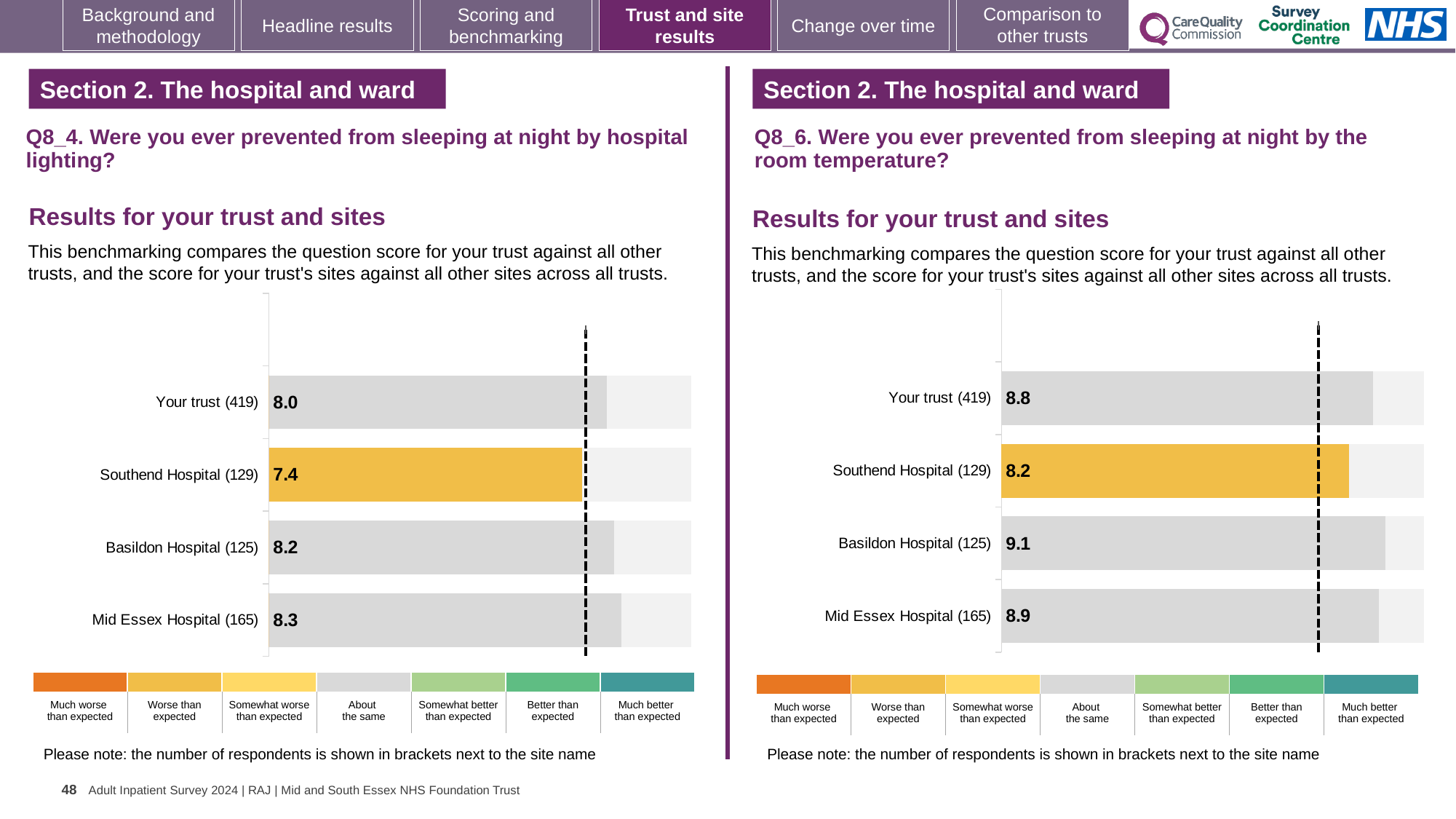
In the Q8_4 chart (hospital lighting), which site has the lowest score? Southend Hospital In the Q8_4 chart (hospital lighting), what is the difference between the scores for Mid Essex Hospital and Southend Hospital? 0.9 In the Q8_4 chart (hospital lighting), which site has the highest score? Mid Essex Hospital In the Q8_6 chart (room temperature), what is the score for Mid Essex Hospital? 8.9 In the Q8_4 chart (hospital lighting), what is the score for Southend Hospital? 7.4 What type of chart is used for the Q8_6 results (room temperature)? Bar chart In the Q8_6 chart (room temperature), which site has the lowest score? Southend Hospital In the Q8_6 chart (room temperature), what is the difference between the scores for Your trust and Southend Hospital? 0.6 In the Q8_4 chart (hospital lighting), what is the score for Your trust? 8.0 In the Q8_6 chart (room temperature), what is the score for Basildon Hospital? 9.1 In the Q8_6 chart (room temperature), which is larger: the score for Basildon Hospital or Your trust? Basildon Hospital How many bars are shown in the Q8_4 chart (hospital lighting)? 4